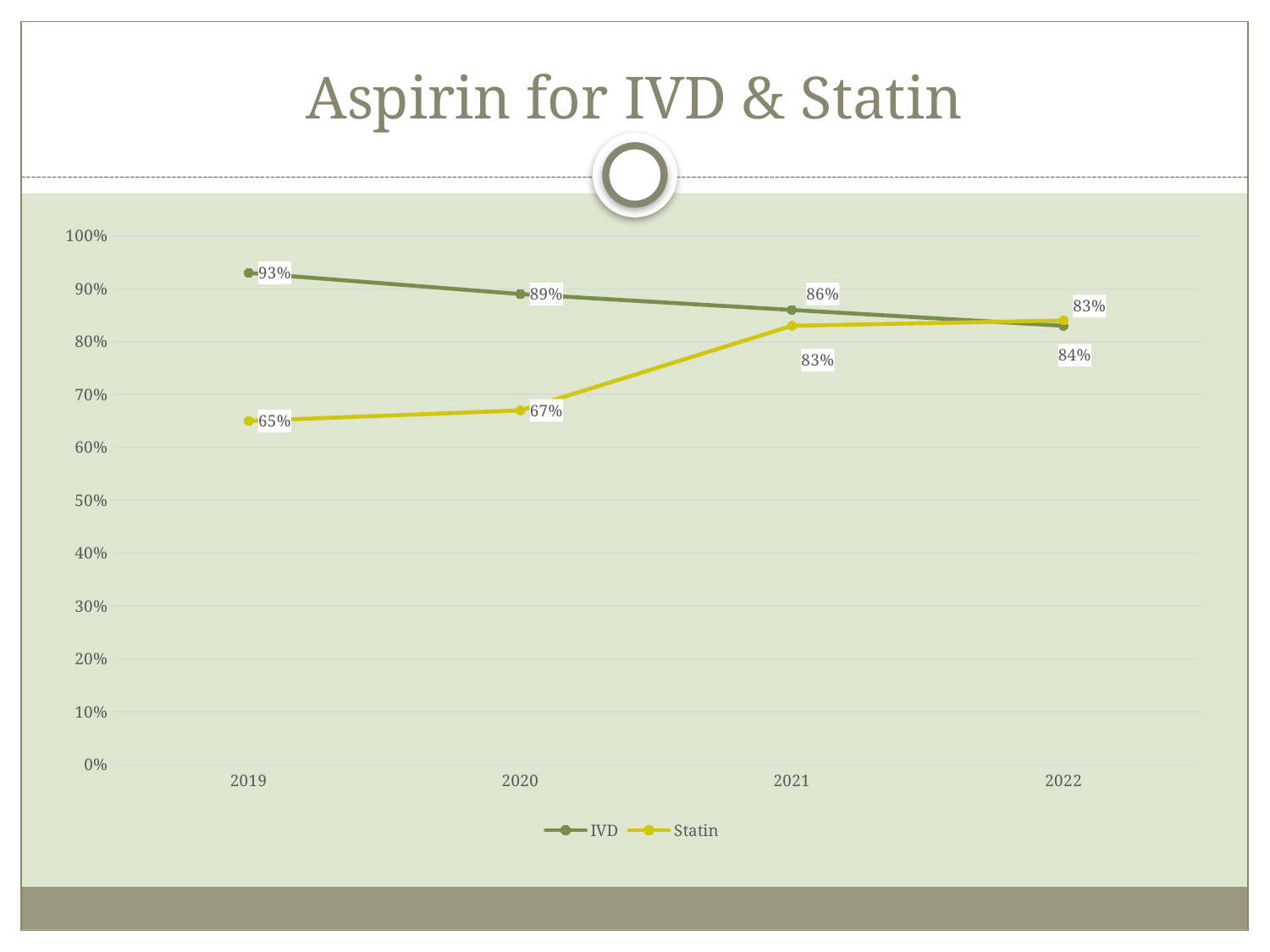
Does the IVD series rise or fall from 2019 to 2022? fall In which year is the IVD value highest? 2019 How many series does the legend list? 2 In which year is the Statin value lowest? 2019 What type of chart is shown on the slide? line chart What is the IVD value in 2019? 93% What is the IVD value in 2020? 89% What is the difference between the IVD and Statin values in 2019? 28% What is the Statin value in 2019? 65% What is the IVD value in 2021? 86% Which series has the larger value in 2020, IVD or Statin? IVD What is the Statin value in 2021? 83%